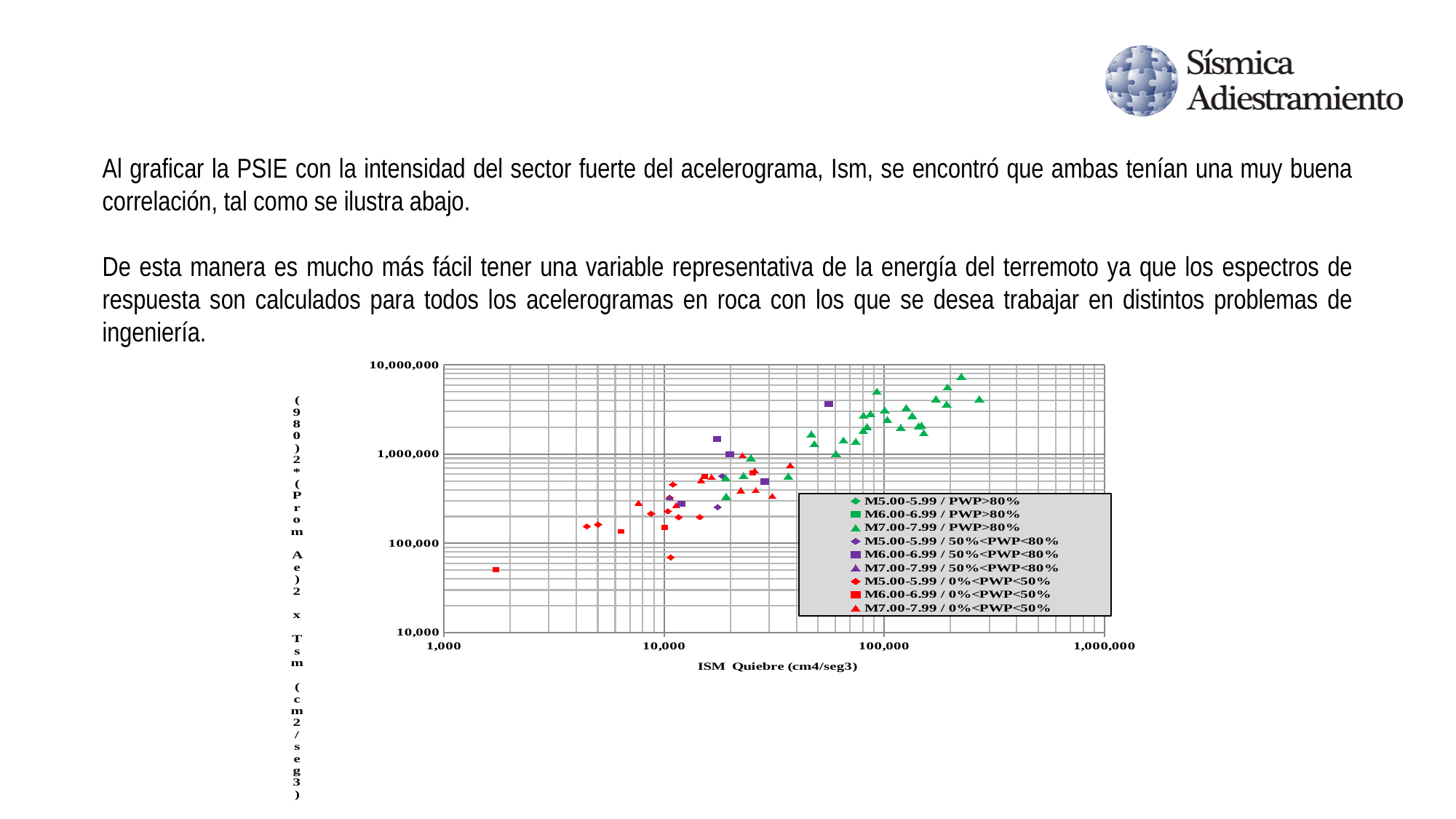
How many series does the chart's legend list? 9 Is the y value of the highest plotted point on the chart greater or less than 1,000,000? greater What is the highest value shown on the y axis of the chart? 10,000,000 Is the x value of the rightmost plotted point greater or less than 100,000? greater Which legend series is plotted with green triangles? M7.00-7.99 / PWP>80% Is the x value of the leftmost plotted point greater or less than 10,000? less What is the title of the x axis of the chart? ISM Quiebre (cm4/seg3) Do the plotted values generally rise or fall as ISM Quiebre increases along the x axis? rise What kind of chart is shown on the slide? scatter chart